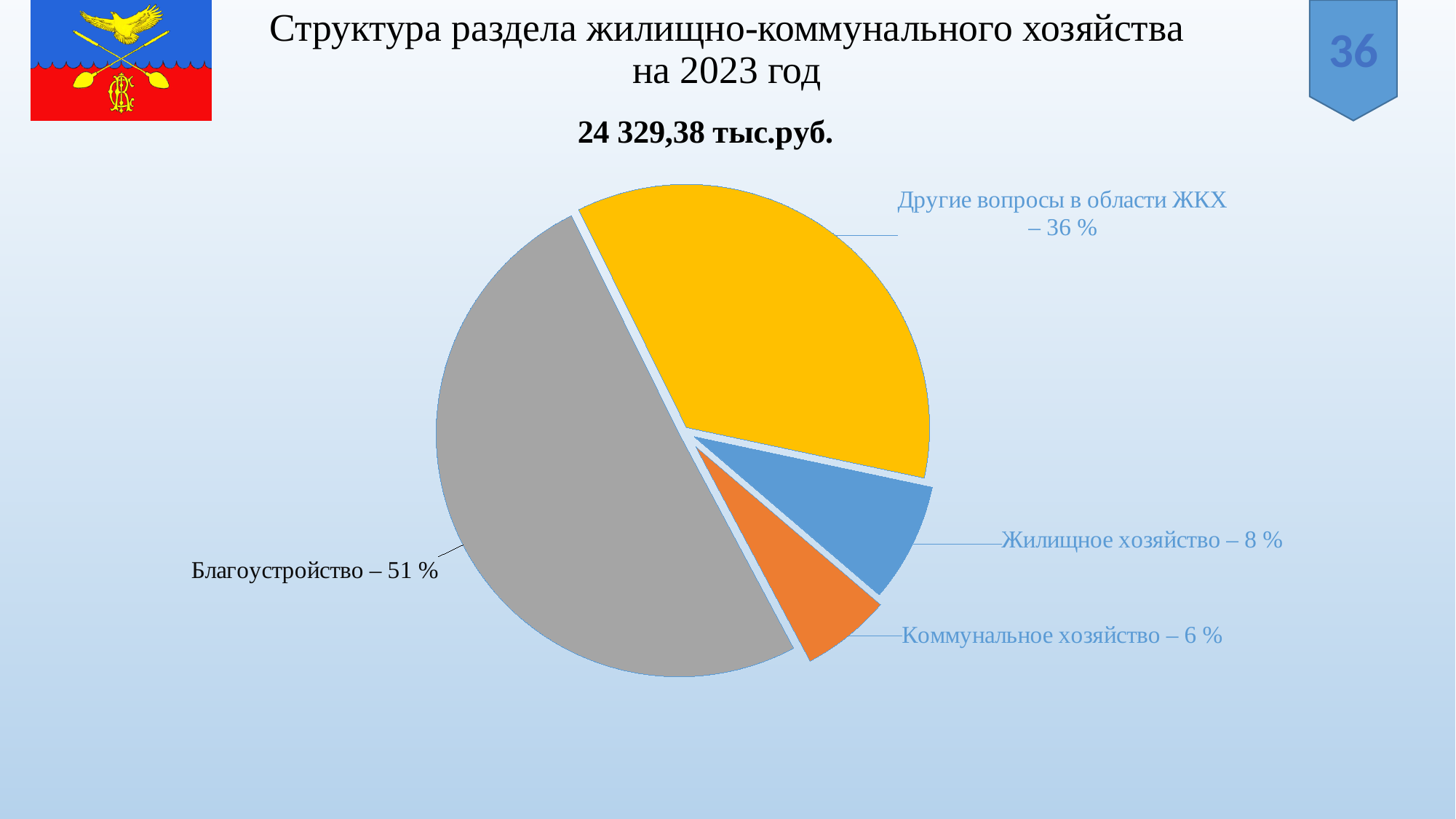
What share of the pie does Жилищное хозяйство have? 8 % How many slices does the pie chart have? 4 Which category has the smallest slice of the pie? Коммунальное хозяйство What share of the pie does Другие вопросы в области ЖКХ have? 36 % Which category has the largest slice of the pie? Благоустройство What share of the pie does Коммунальное хозяйство have? 6 % Which is larger, the share for Жилищное хозяйство or the share for Коммунальное хозяйство? Жилищное хозяйство What is the difference in percentage points between Благоустройство and Другие вопросы в области ЖКХ? 15 What kind of chart is shown on the slide? Pie chart What colour is the slice for Благоустройство? Grey What total amount is shown above the pie chart? 24 329,38 тыс.руб.